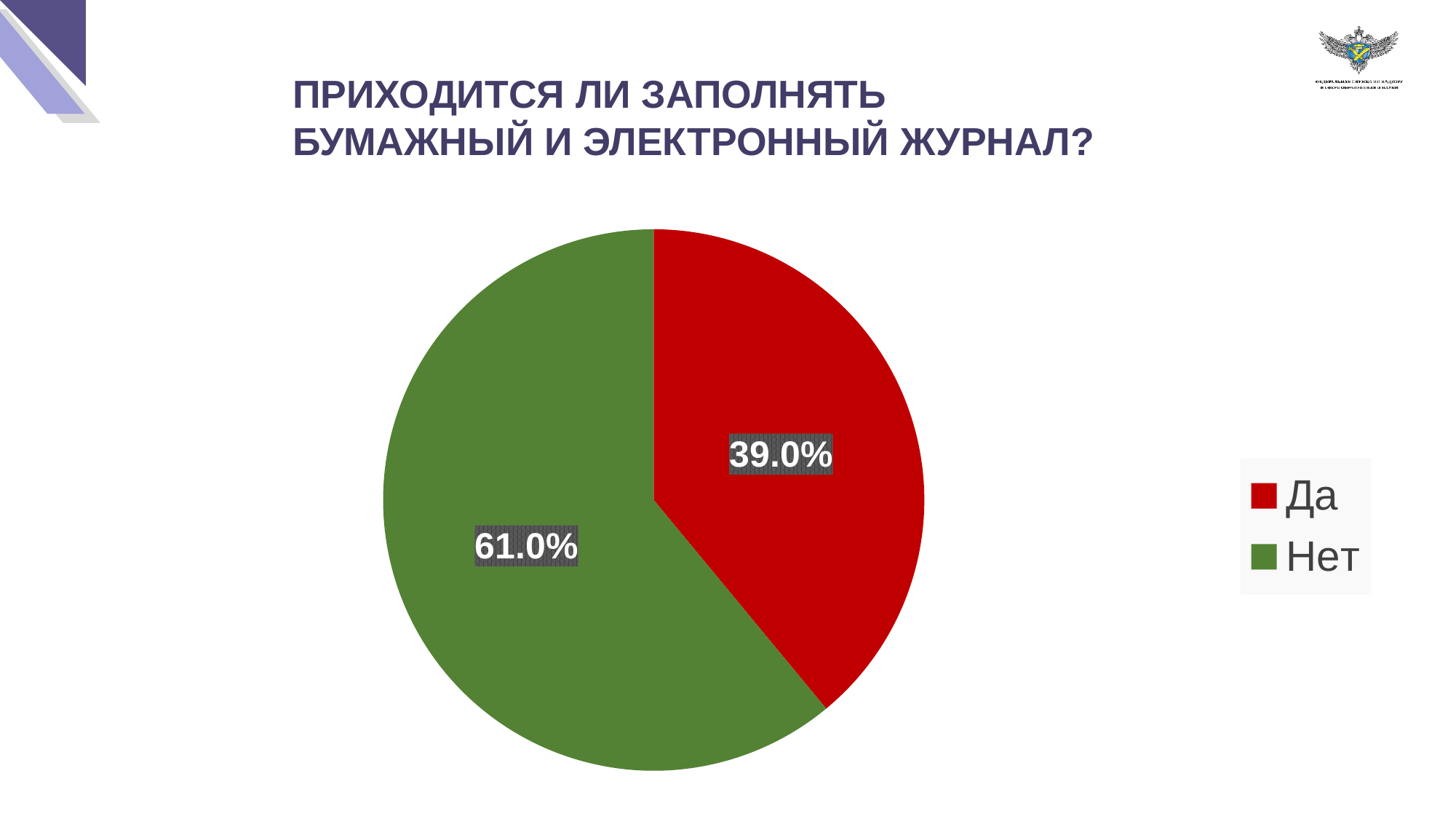
How many slices does the pie chart have? 2 How many entries does the legend list? 2 What share of the pie does the "Да" slice represent? 39.0% What is the difference between the shares for "Нет" and "Да"? 22.0% What is the value for "Да"? 39.0% Which category has the smallest share of the pie? Да What colour is the "Да" slice? red What colour is the "Нет" slice? green What is the value for "Нет"? 61.0% Which is larger, the share for "Да" or the share for "Нет"? Нет What kind of chart is shown on the slide? pie chart Which category has the largest share of the pie? Нет